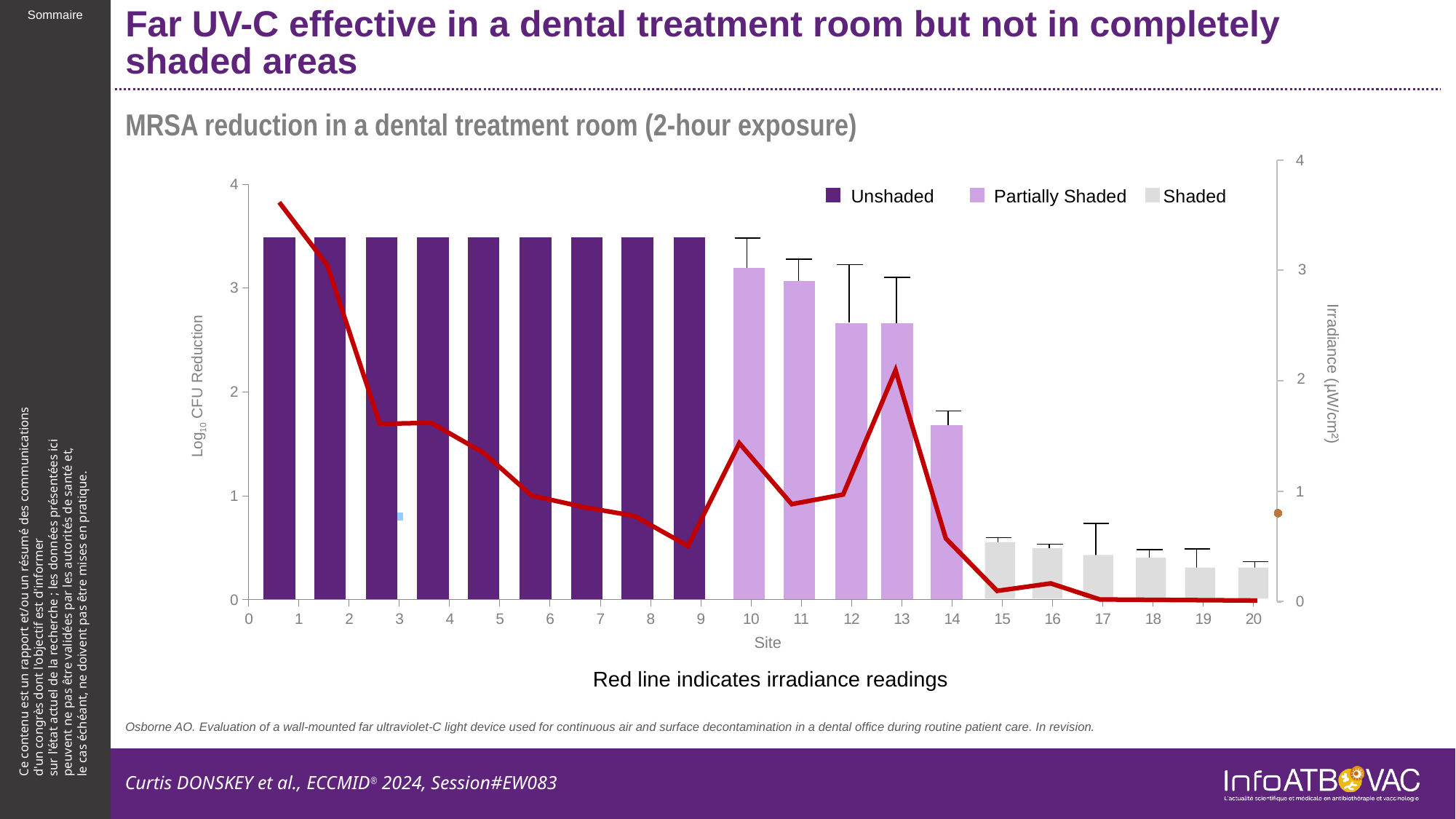
Is the Log10 CFU Reduction value for site 14 greater or less than 1? greater Is the Log10 CFU Reduction value for site 10 greater or less than 3? greater How many series does the legend list? 3 Is the Log10 CFU Reduction value for site 15 greater or less than 1? less What kind of chart is shown on the slide? Bar chart (with a line overlay) Which site has the larger Log10 CFU Reduction, site 10 or site 14? Site 10 What are the three series named in the legend? Unshaded, Partially Shaded, Shaded Which site has the larger Log10 CFU Reduction, site 11 or site 16? Site 11 How many sites are plotted along the x axis? 20 According to the slide, what does the red line indicate? Irradiance readings Do the Partially Shaded bars rise or fall from site 10 to site 14? Fall